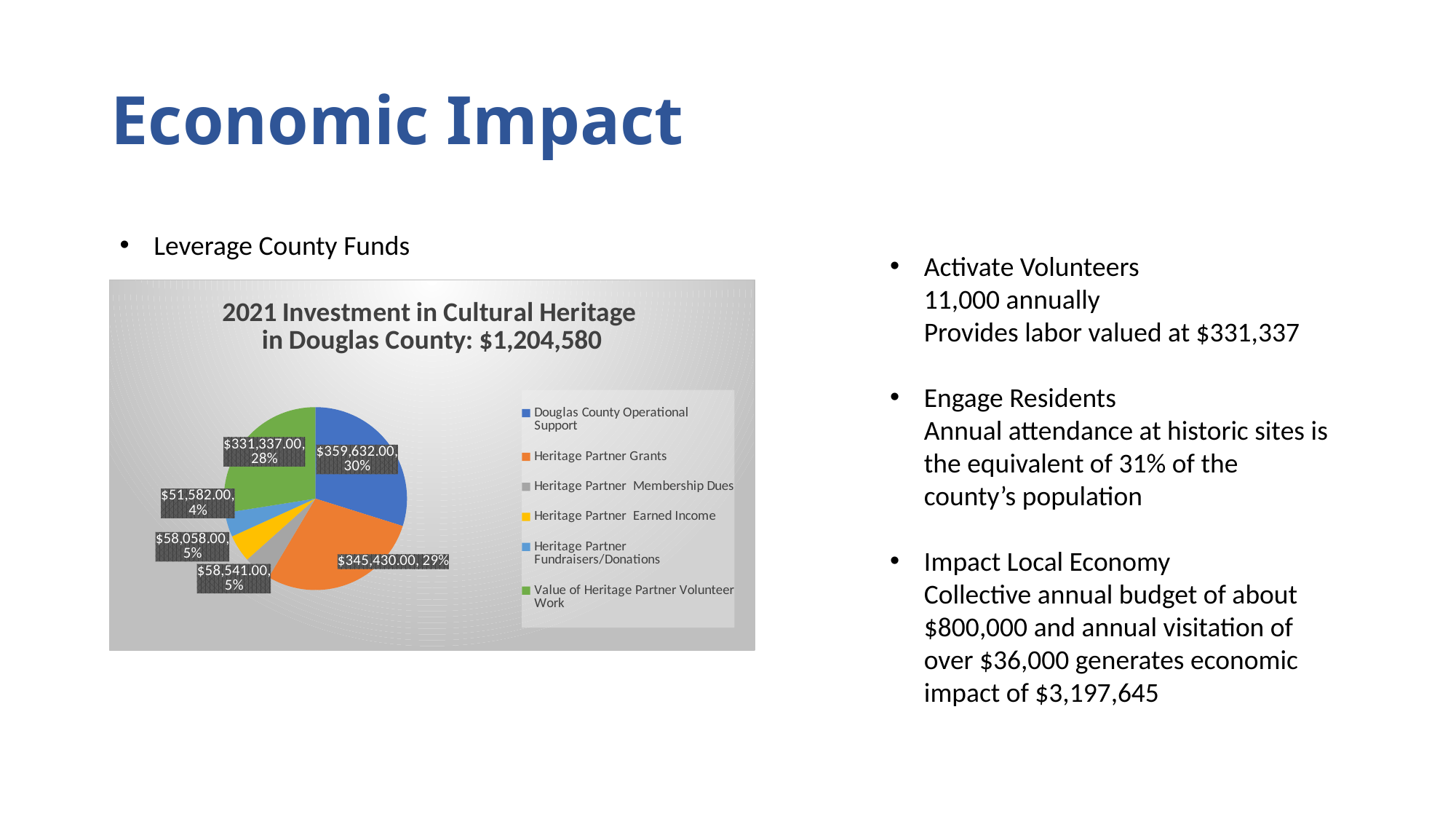
What is the value shown for Value of Heritage Partner Volunteer Work? $331,337.00 How many slices does the pie chart have? 6 What is the difference between the Douglas County Operational Support value and the Heritage Partner Grants value? $14,202.00 What is the value shown for Douglas County Operational Support? $359,632.00 What kind of chart is shown on the slide? pie chart Which category has the largest slice of the pie? Douglas County Operational Support What total investment amount is stated in the chart title? $1,204,580 Which category has the smallest slice of the pie? Heritage Partner Fundraisers/Donations How many entries does the legend of the pie chart list? 6 What share of the pie does Heritage Partner Grants represent? 29% What is the value shown for Heritage Partner Grants? $345,430.00 What share of the pie does Heritage Partner Fundraisers/Donations represent? 4%